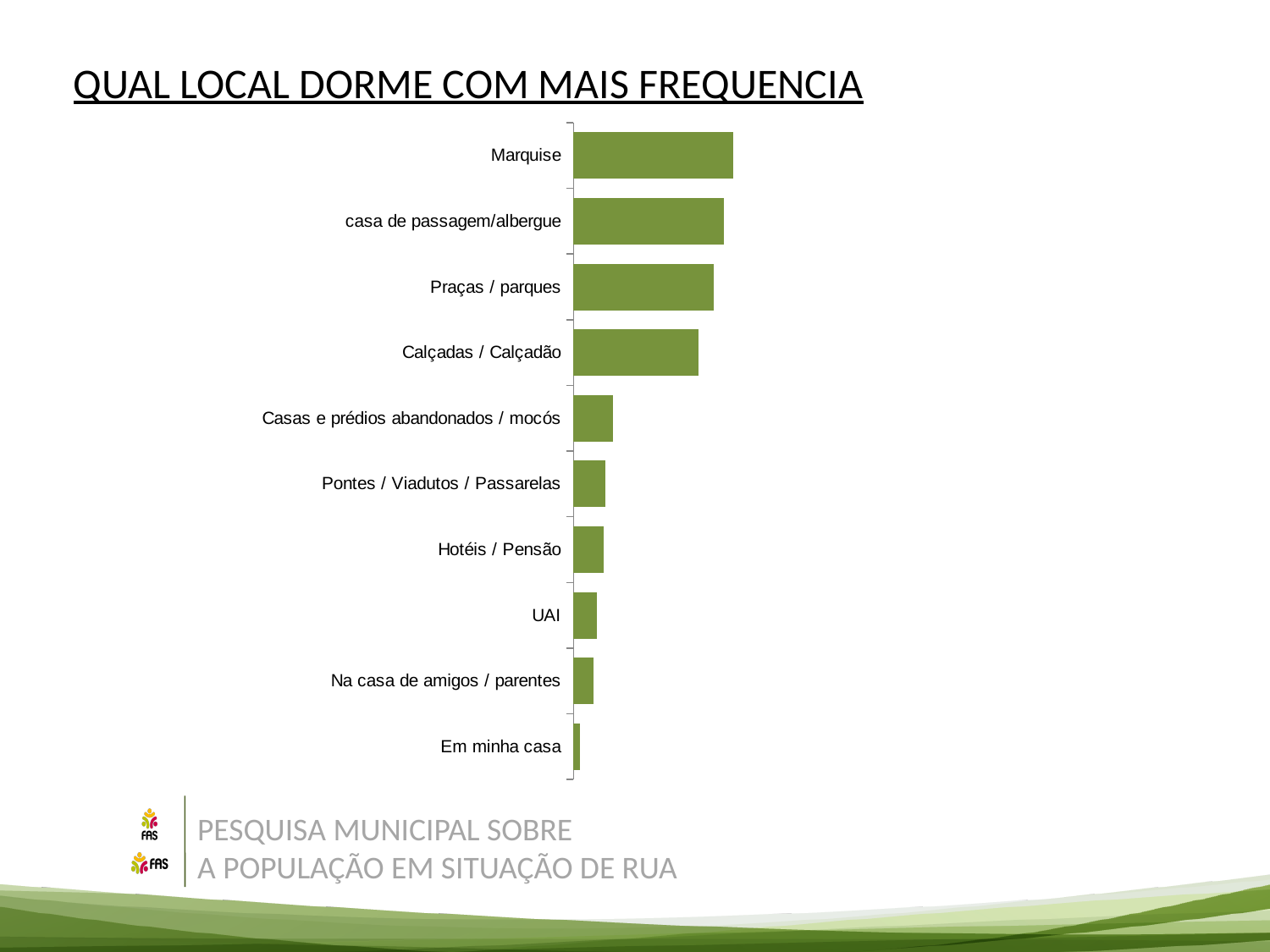
What colour are the bars in the chart? green Which has the larger value, Hotéis / Pensão or UAI? Hotéis / Pensão Which has the larger value, Calçadas / Calçadão or Casas e prédios abandonados / mocós? Calçadas / Calçadão How many categories are plotted in the chart? 10 Which has the larger value, casa de passagem/albergue or Pontes / Viadutos / Passarelas? casa de passagem/albergue Which category has the longest bar? Marquise What is the title of the chart? QUAL LOCAL DORME COM MAIS FREQUENCIA Which category has the shortest bar? Em minha casa What kind of chart is shown on the slide? bar chart Do the bar lengths increase or decrease going from the top category to the bottom category? decrease